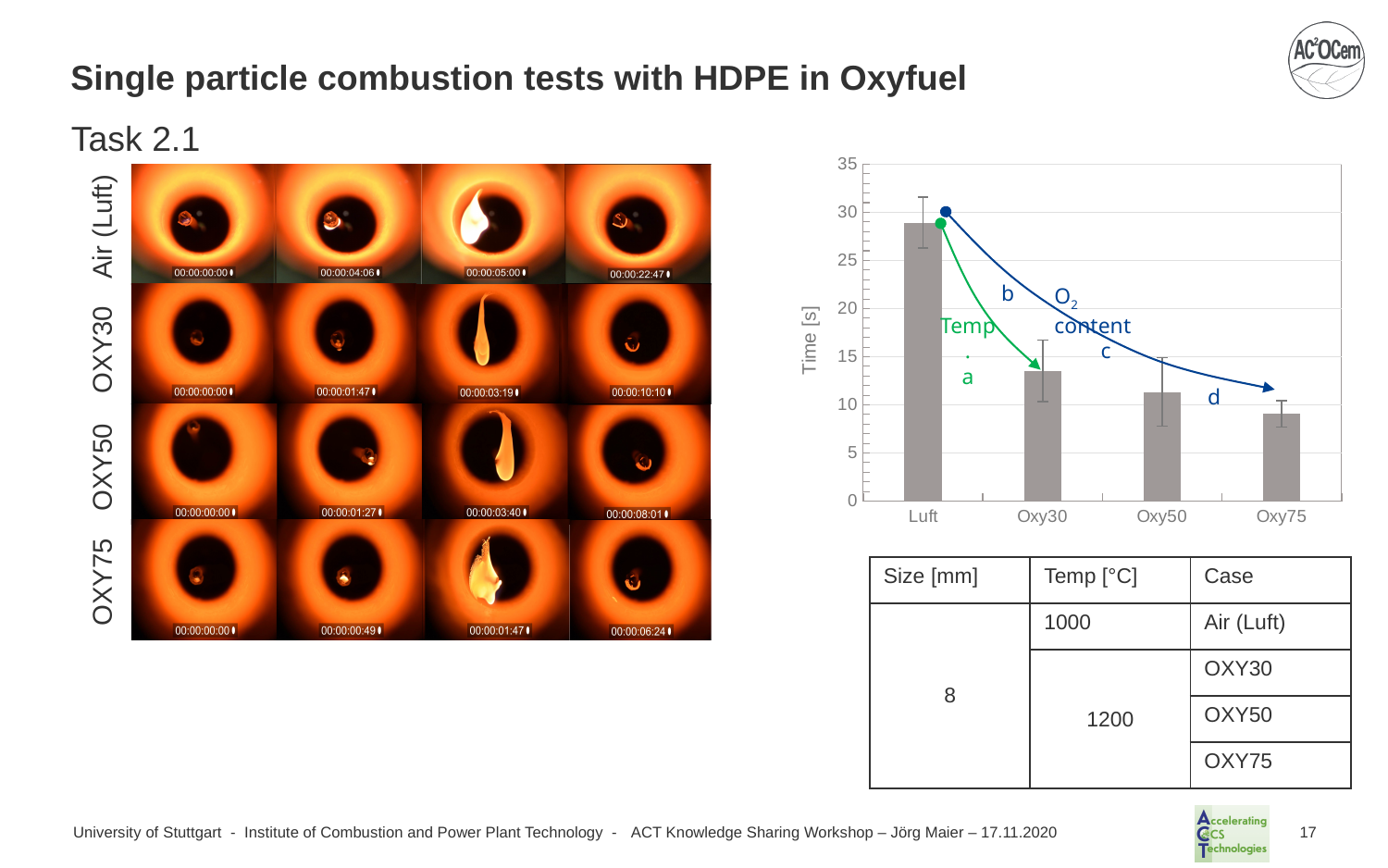
Is the value for Oxy75 greater or less than 10? less Is the value for Oxy50 greater or less than 15? less Do the bar values rise or fall from Luft to Oxy75 along the x axis? fall Which is larger, the value for Oxy30 or the value for Oxy75? Oxy30 Which is larger, the value for Luft or the value for Oxy30? Luft What is the label of the y axis of the bar chart? Time [s] How many categories are plotted on the x axis of the bar chart? 4 Is the value for Luft greater or less than 25? greater What kind of chart is shown on the slide? bar chart Which category has the lowest time value in the bar chart? Oxy75 Which category has the highest time value in the bar chart? Luft